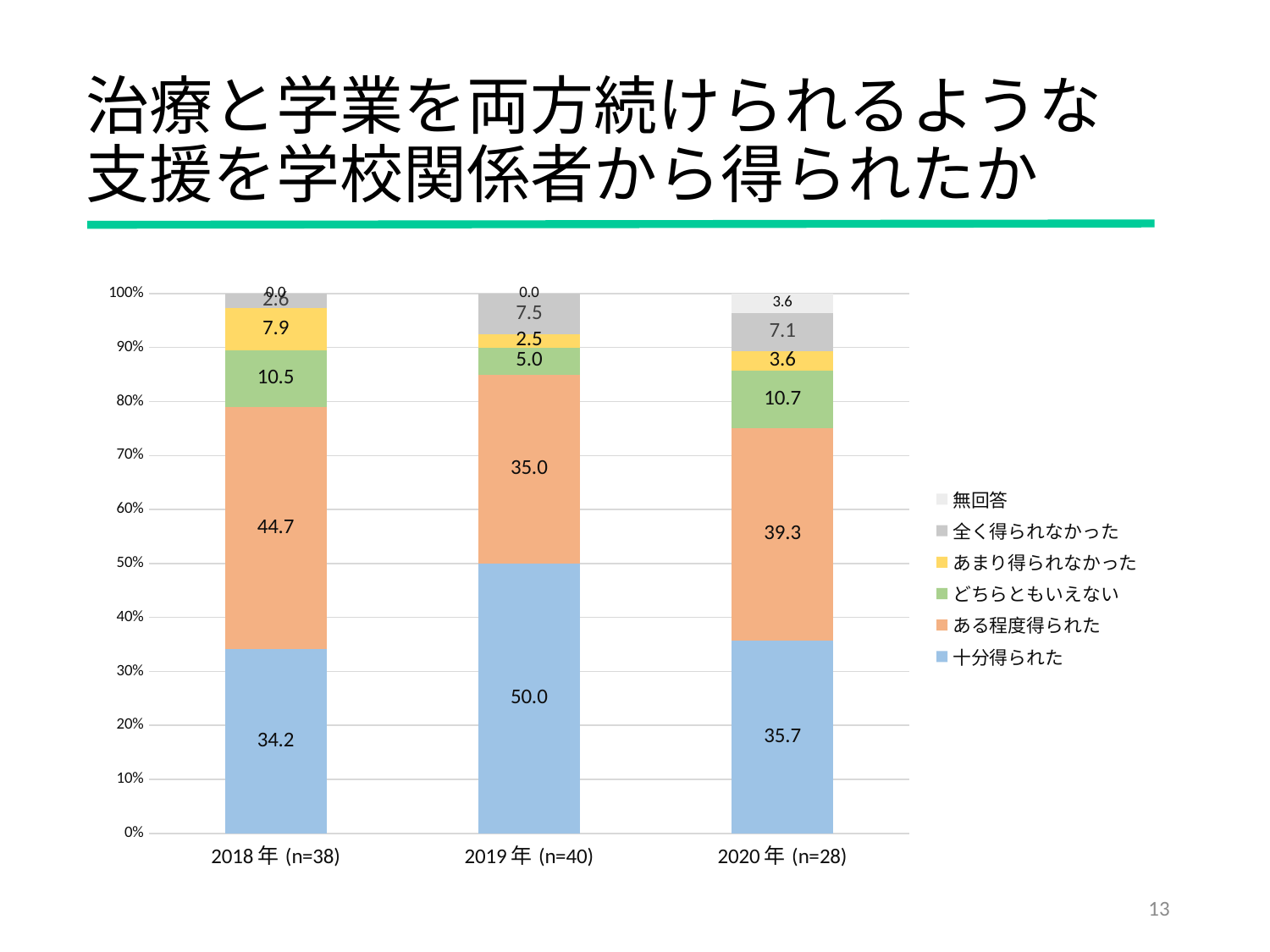
What is the value for 全く得られなかった in 2019年 (n=40)? 7.5 What is the sample size shown for 2020年? n=28 Which is larger in 2020年 (n=28): ある程度得られた or 十分得られた? ある程度得られた What is the value for 十分得られた in 2019年 (n=40)? 50.0 What is the value for どちらともいえない in 2020年 (n=28)? 10.7 Which year has the lowest value for あまり得られなかった? 2019年 (n=40) What is the difference between the 十分得られた values for 2019年 (n=40) and 2018年 (n=38)? 15.8 What is the value for ある程度得られた in 2018年 (n=38)? 44.7 How many year categories are shown on the x axis? 3 How many series does the legend list? 6 What kind of chart is shown on the slide? stacked bar chart Which year has the highest value for 十分得られた? 2019年 (n=40)